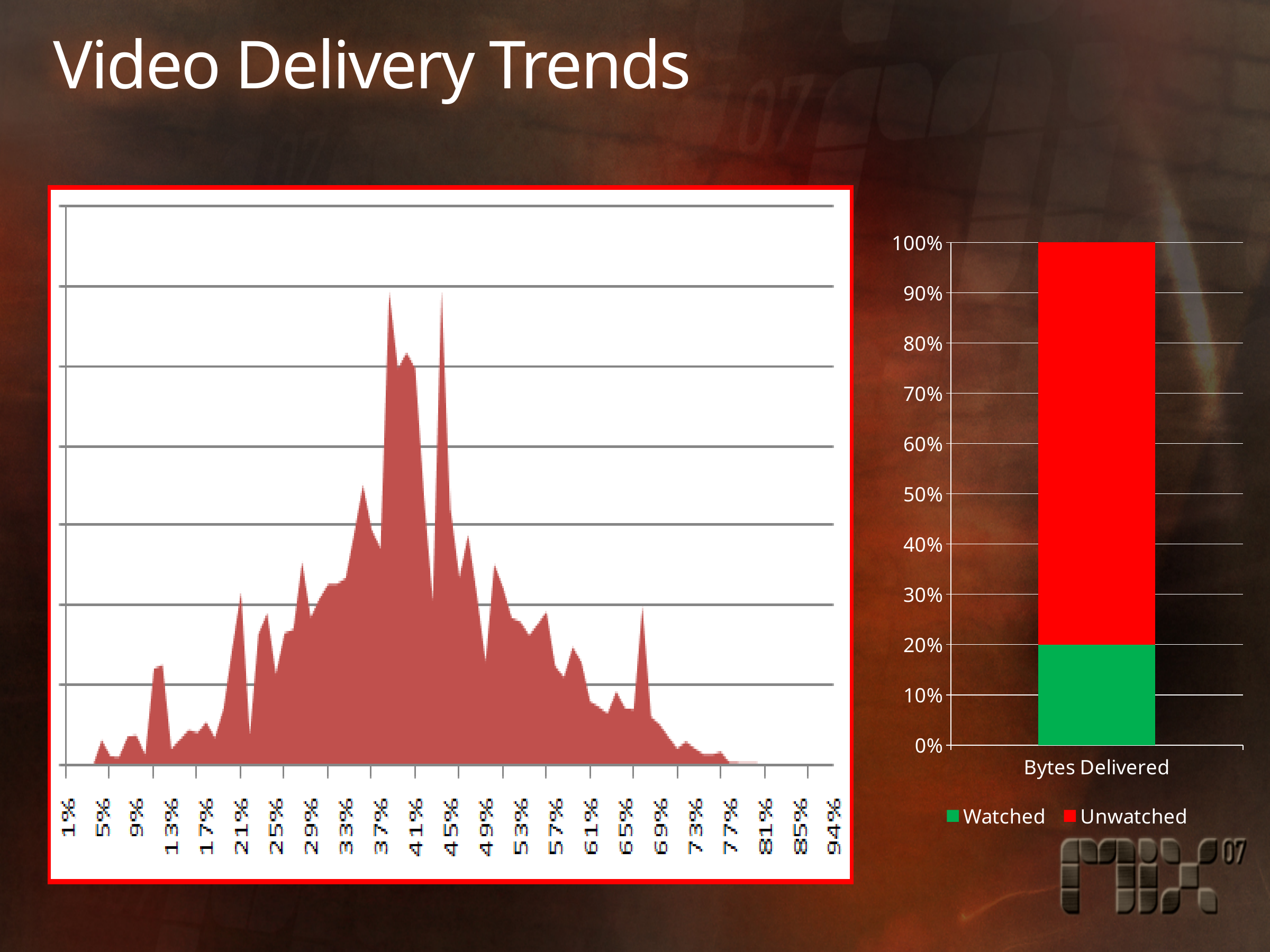
What kind of chart is the chart on the right of the slide? bar chart In the right-hand chart, what are the two series named in the legend? Watched and Unwatched In the right-hand chart, what is the value for Watched? 20% In the right-hand chart, how many categories are shown on the x axis? 1 In the right-hand chart, which is larger, Watched or Unwatched? Unwatched In the right-hand chart, what is the total of the stacked bar for Bytes Delivered? 100% What kind of chart is the chart on the left of the slide? area chart In the right-hand chart, is the value for Watched greater or less than 50%? less In the right-hand chart, how many series does the legend list? 2 In the right-hand chart, what is the category label on the x axis? Bytes Delivered In the right-hand chart, is the value for Unwatched greater or less than 50%? greater In the left-hand chart, what is the first label on the x axis? 1%